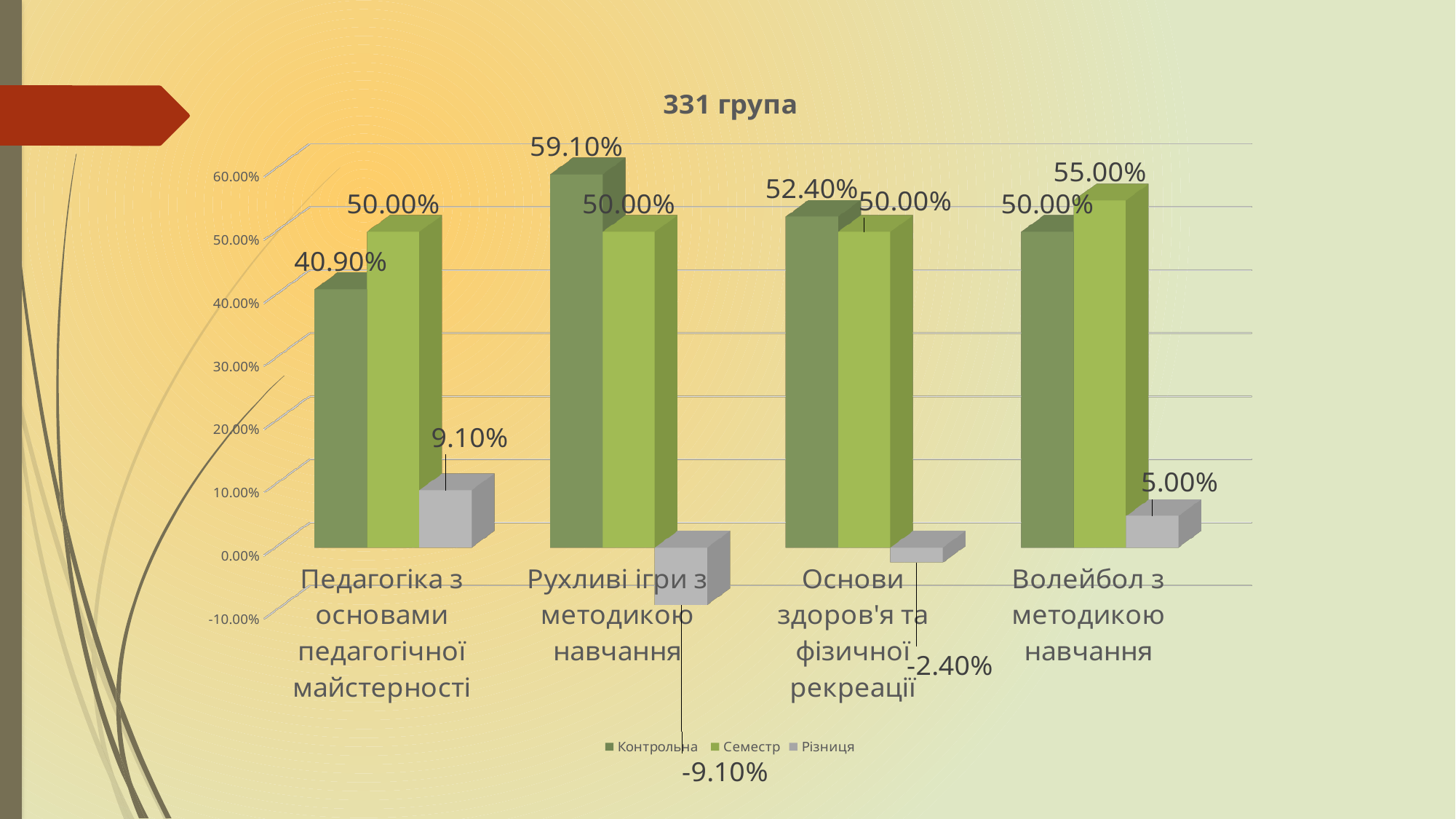
What is the difference between the Семестр and Контрольна values for Педагогіка з основами педагогічної майстерності? 9.10% What type of chart is shown on the slide? bar chart Which category has the highest Контрольна value? Рухливі ігри з методикою навчання What is the Контрольна value for Рухливі ігри з методикою навчання? 59.10% What is the Контрольна value for Педагогіка з основами педагогічної майстерності? 40.90% What is the title of the chart? 331 група Which category has the lowest Різниця value? Рухливі ігри з методикою навчання What is the Різниця value for Основи здоров'я та фізичної рекреації? -2.40% For Основи здоров'я та фізичної рекреації, which is larger: the Контрольна value or the Семестр value? Контрольна What is the Семестр value for Волейбол з методикою навчання? 55.00% How many categories are shown on the x axis? 4 How many series does the legend list? 3